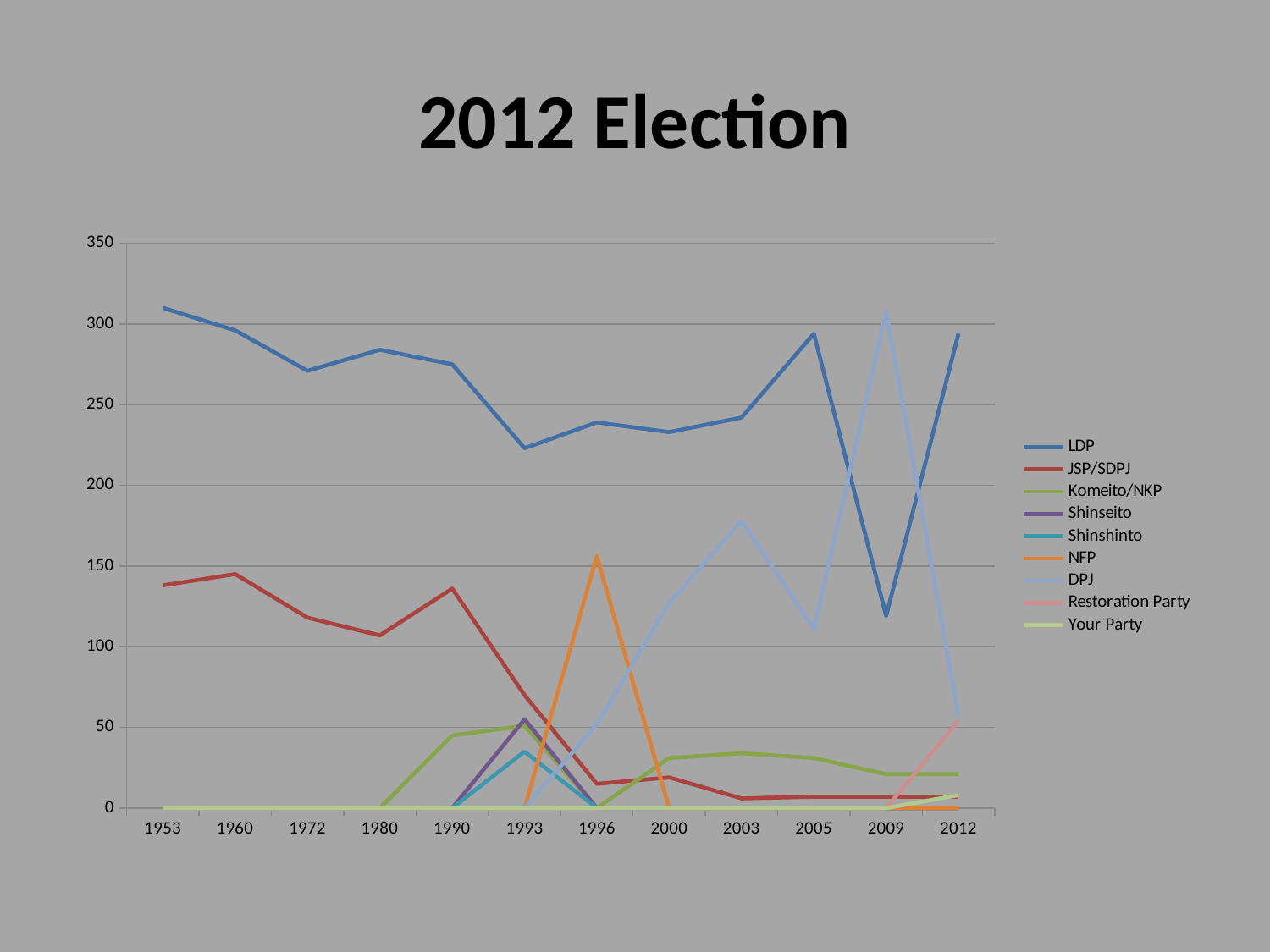
Which party has the highest value in 2009? DPJ In which year is the LDP line at its lowest? 2009 Does the JSP/SDPJ line rise or fall overall from 1953 to 2012? fall Is the value for LDP in 1993 greater or less than 250? less How many series does the legend list? 9 Is the value for JSP/SDPJ in 1990 greater or less than 100? greater Is the value for LDP in 1953 greater or less than 300? greater How many election years are shown along the x axis? 12 Which is larger in 1996, LDP or NFP? LDP What kind of chart is shown on the slide? line chart